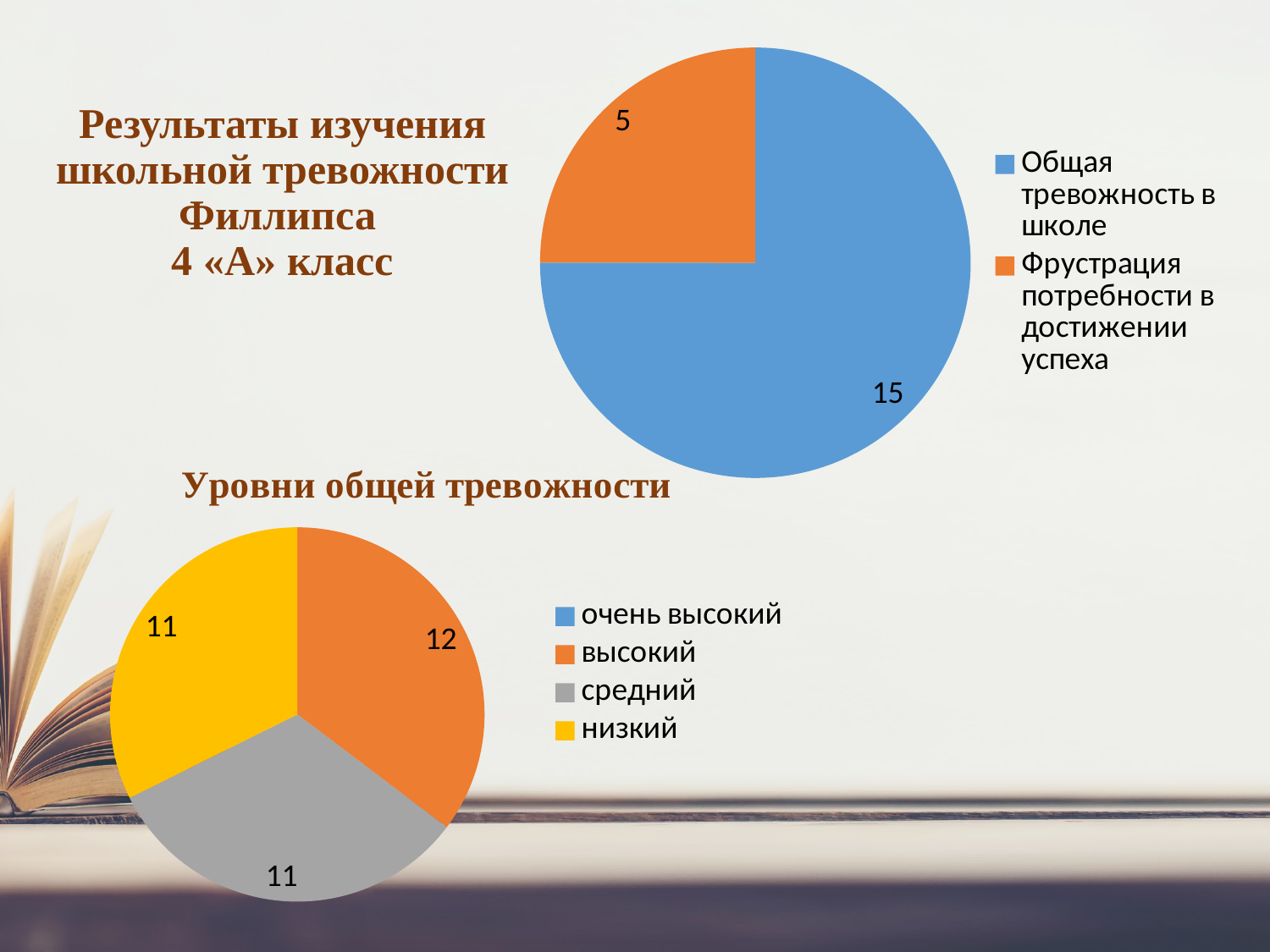
In the top-right pie chart, which colour is used for "Фрустрация потребности в достижении успеха"? Orange In the top-right pie chart, what share of the pie does "Общая тревожность в школе" represent? 75% In the top-right pie chart, what is the value for "Фрустрация потребности в достижении успеха"? 5 In the top-right pie chart, what is the difference between the values for "Общая тревожность в школе" and "Фрустрация потребности в достижении успеха"? 10 In the chart titled "Уровни общей тревожности", which labelled slice has the highest value? высокий What kind of chart is the top-right chart on the slide? Pie chart In the chart titled "Уровни общей тревожности", what is the value for "средний"? 11 In the chart titled "Уровни общей тревожности", what is the difference between the values for "высокий" and "низкий"? 1 In the top-right pie chart, how many entries does the legend list? 2 In the chart titled "Уровни общей тревожности", how many entries does the legend list? 4 In the top-right pie chart, what is the value for "Общая тревожность в школе"? 15 In the chart titled "Уровни общей тревожности", what is the value for "высокий"? 12